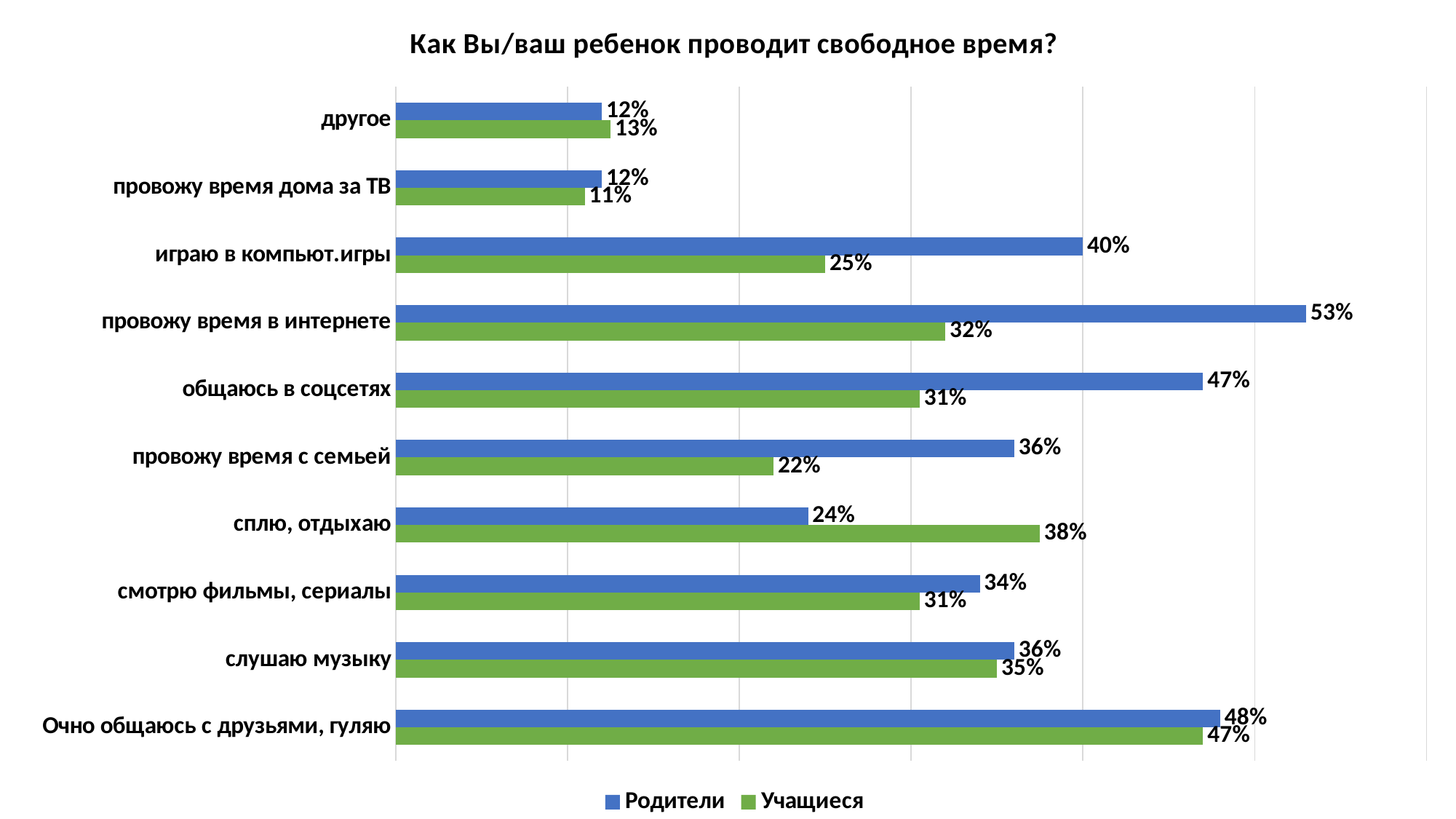
In the category 'сплю, отдыхаю', which series has the larger value, Родители or Учащиеся? Учащиеся What is the value for Учащиеся in the category 'сплю, отдыхаю'? 38% How many categories are shown on the chart? 10 Which category has the lowest value for Учащиеся? провожу время дома за ТВ What is the difference between Родители and Учащиеся in the category 'провожу время в интернете'? 21% What kind of chart is shown on the slide? bar chart Which category has the highest value for Родители? провожу время в интернете What is the title of the chart? Как Вы/ваш ребенок проводит свободное время? Which category has the highest value for Учащиеся? Очно общаюсь с друзьями, гуляю What is the value for Родители in the category 'провожу время в интернете'? 53% What is the value for Учащиеся in the category 'играю в компьют.игры'? 25% How many series does the legend list? 2